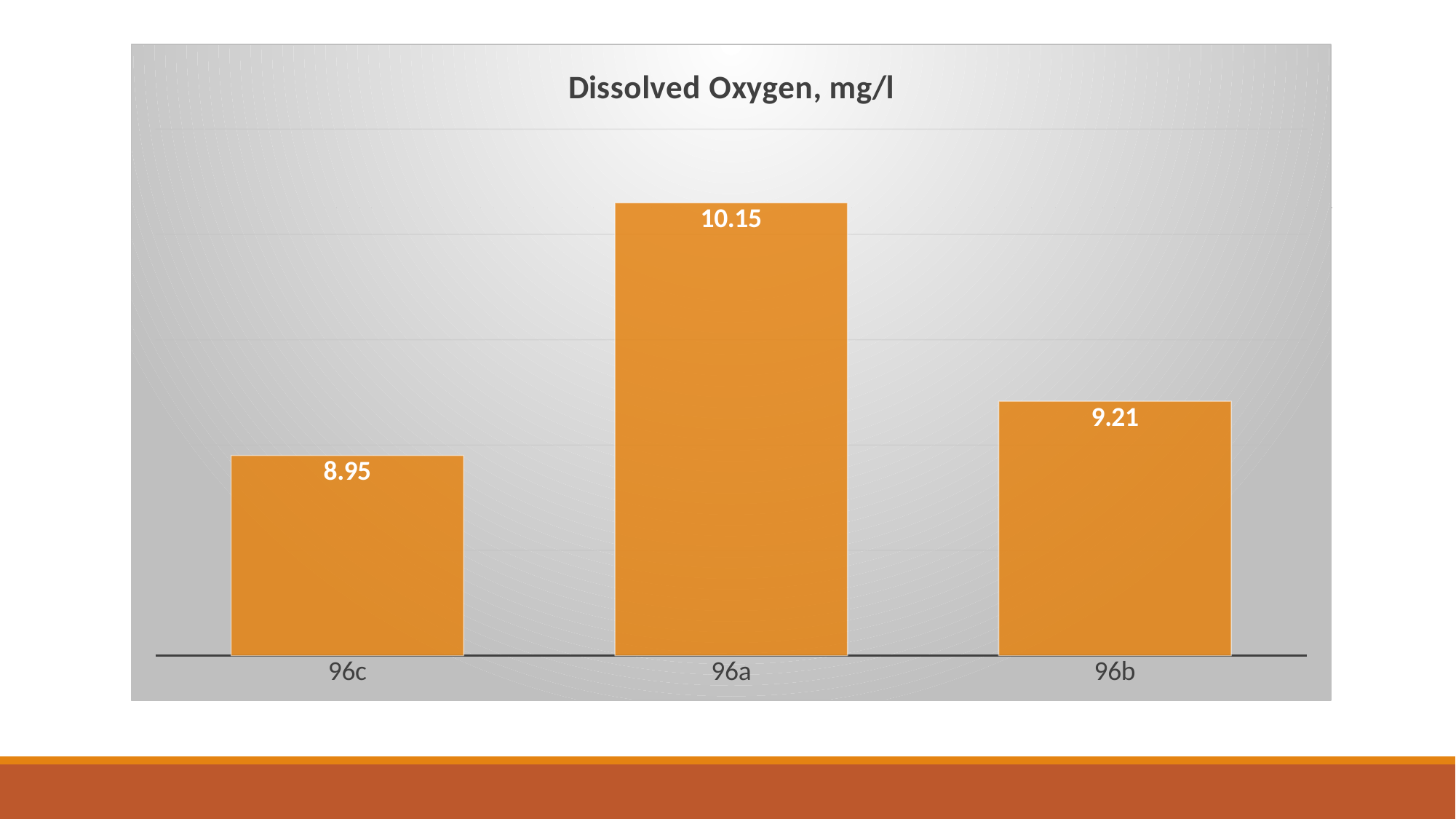
What is the dissolved oxygen value for 96c? 8.95 Which has a larger dissolved oxygen value, 96b or 96c? 96b What colour are the bars in the chart? orange What is the title of the chart? Dissolved Oxygen, mg/l What kind of chart is shown on the slide? bar chart Which category has the highest dissolved oxygen value? 96a What is the difference between the dissolved oxygen values for 96a and 96c? 1.20 What is the dissolved oxygen value for 96a? 10.15 What is the difference between the dissolved oxygen values for 96b and 96c? 0.26 Which category has the lowest dissolved oxygen value? 96c How many categories are shown on the chart? 3 What is the dissolved oxygen value for 96b? 9.21